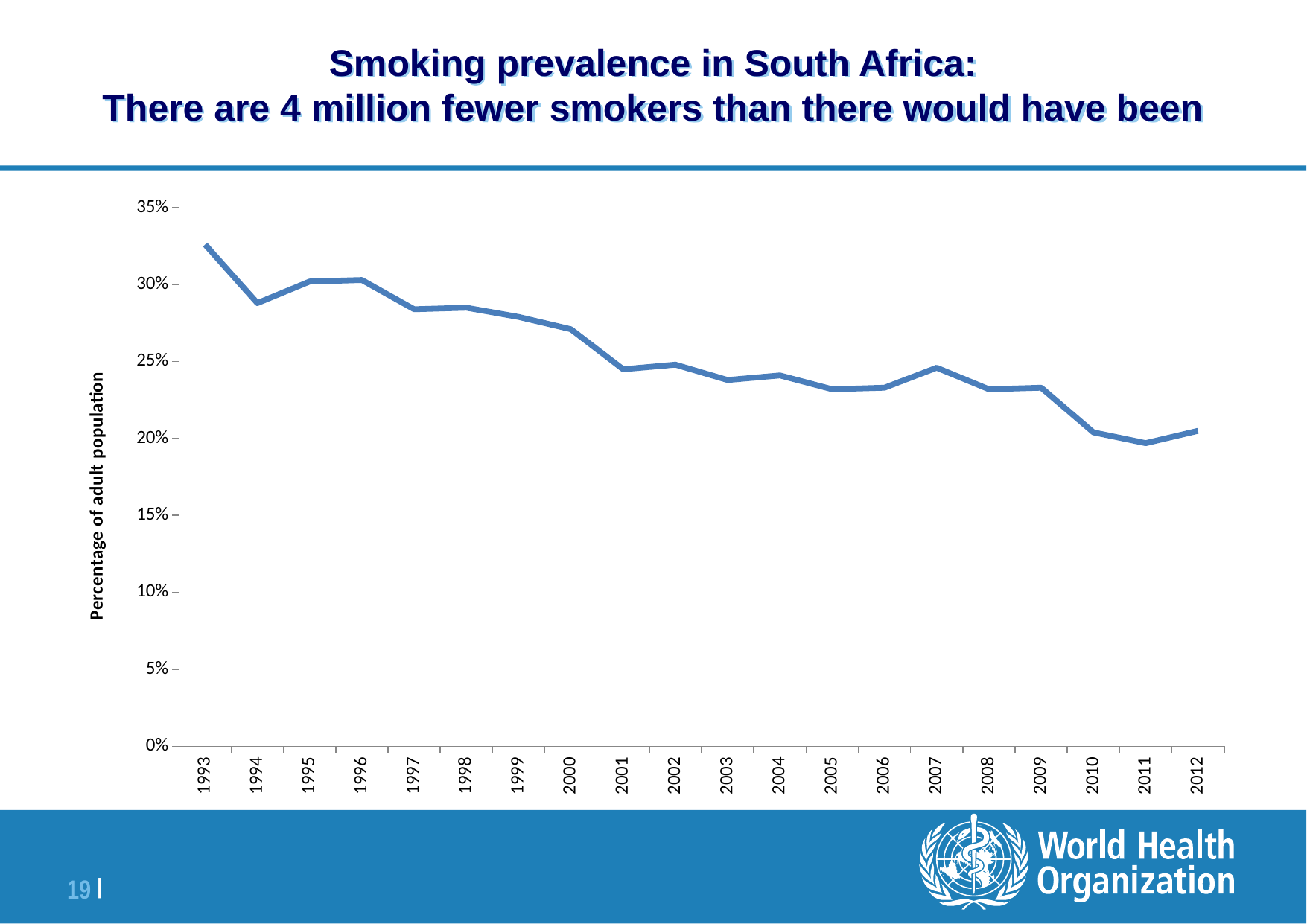
Which year has the larger value, 1993 or 2012? 1993 Which year has the highest smoking prevalence? 1993 Is the value for 1993 greater or less than 30%? greater Do the values generally rise or fall from 1993 to 2012? fall Which year has the larger value, 1996 or 1997? 1996 How many years are plotted along the x axis? 20 Is the value for 2011 greater or less than 20%? less Is the value for 2000 greater or less than 25%? greater What kind of chart is shown on the slide? line chart Which year has the lowest smoking prevalence? 2011 What is the label on the y axis? Percentage of adult population